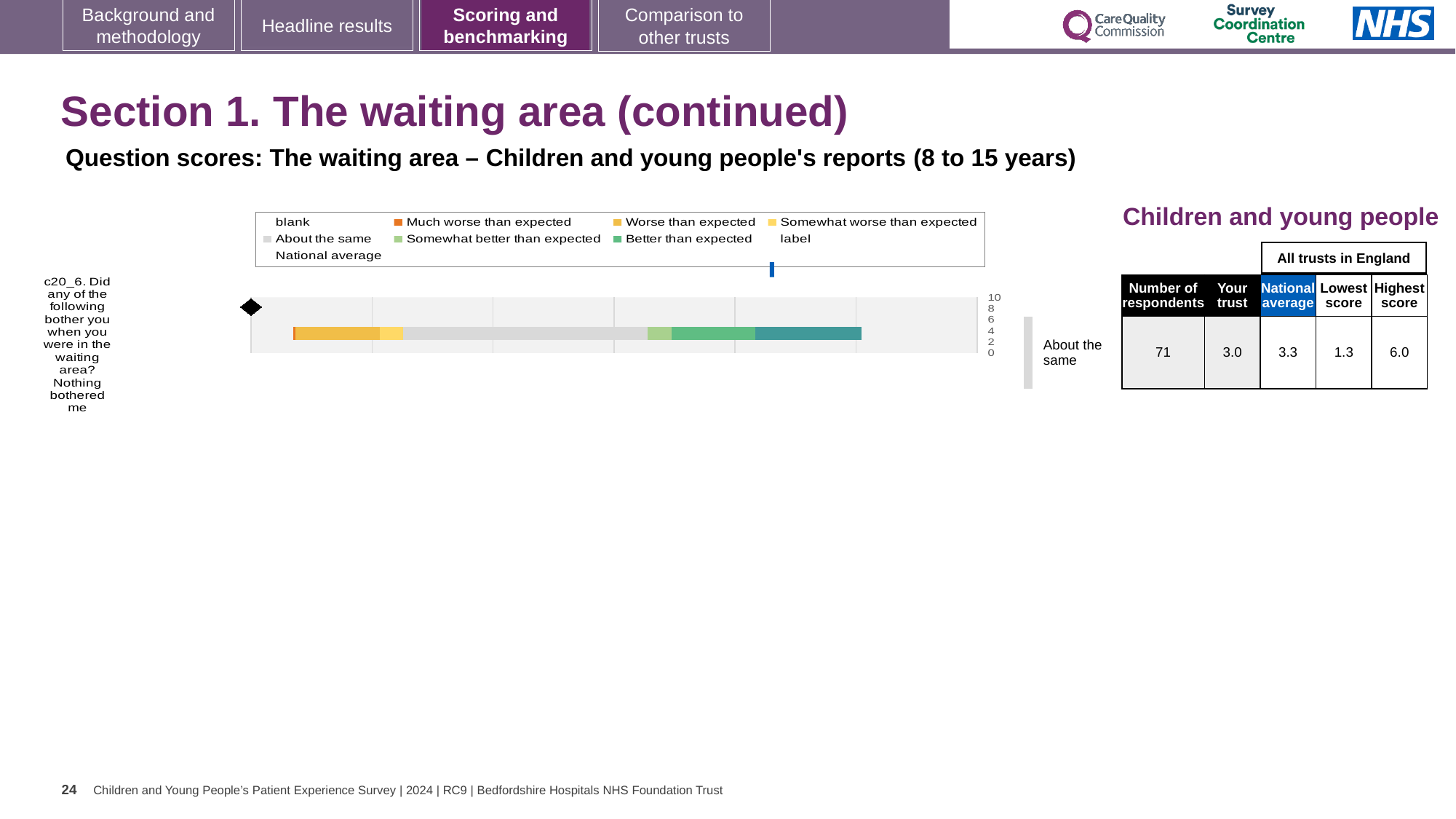
Which is larger for question c20_6: the 'Your trust' score or the national average? National average What is the lowest score among all trusts in England for question c20_6? 1.3 What is the national average score for question c20_6? 3.3 How many respondents answered question c20_6? 71 Which legend entry is shown in orange? Much worse than expected What is the highest score among all trusts in England for question c20_6? 6.0 What is the difference between the highest score (6.0) and the lowest score (1.3) for question c20_6? 4.7 How many survey questions are plotted in the chart? 1 How many entries does the legend of the chart list? 9 What benchmark category label is shown to the right of the bar for question c20_6? About the same What kind of chart is used to show the question score for c20_6 on this slide? Bar chart What is the 'Your trust' score for question c20_6 (Nothing bothered me in the waiting area)? 3.0